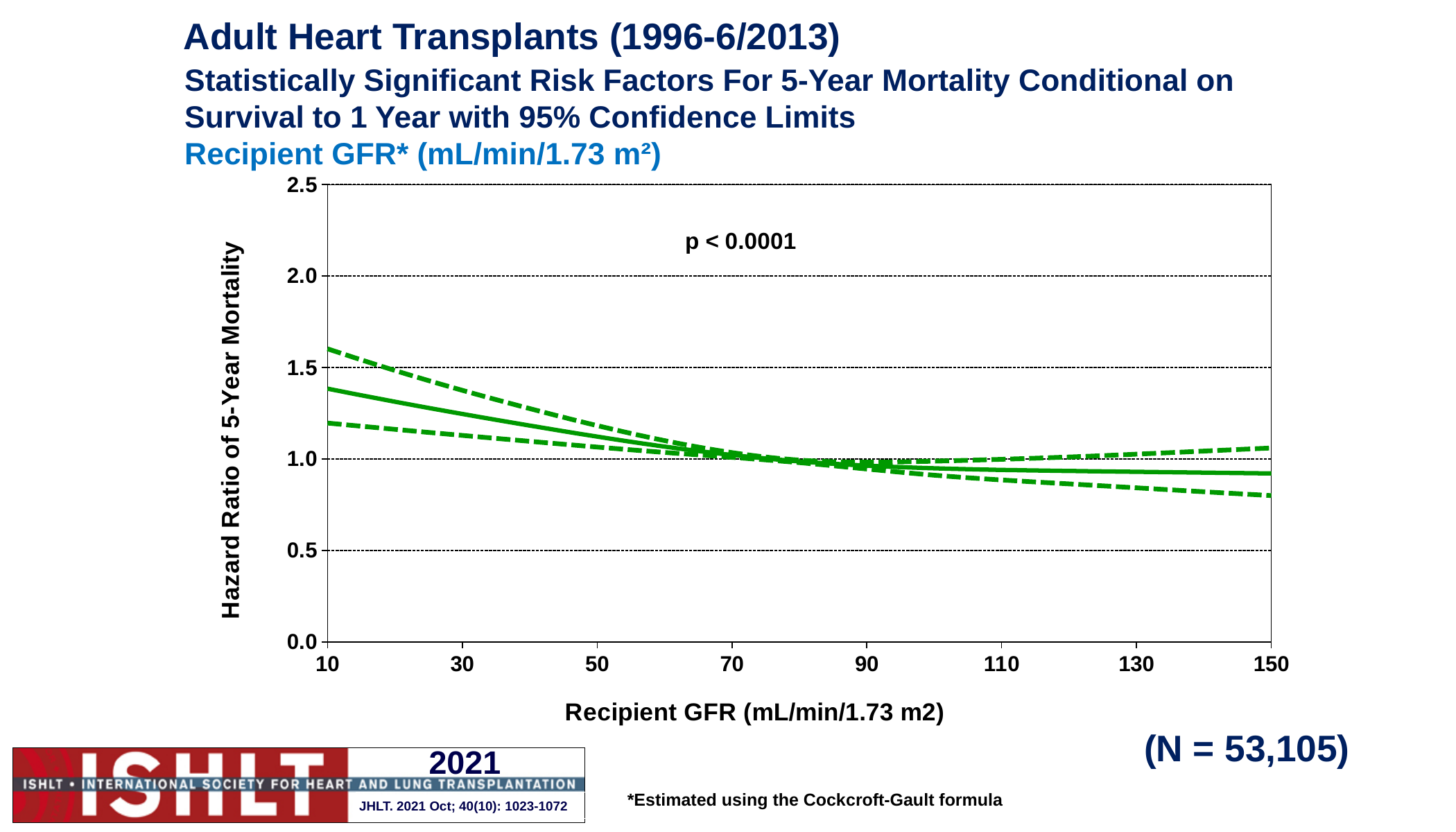
What kind of chart is shown on the slide? Line chart Is the hazard ratio (solid line) at a recipient GFR of 30 greater or less than 1.0? greater Is the upper 95% confidence limit (upper dashed line) at a recipient GFR of 10 greater or less than 1.5? greater Is the hazard ratio (solid line) at a recipient GFR of 10 greater or less than 1.5? less How many lines are plotted on the chart? 3 What is the sample size (N) shown on the slide? N = 53,105 Is the hazard ratio (solid line) higher at a recipient GFR of 10 or at a recipient GFR of 150? 10 Does the hazard ratio of 5-year mortality (solid line) rise or fall as recipient GFR increases from 10 to 150? Fall What p-value is shown on the chart? p < 0.0001